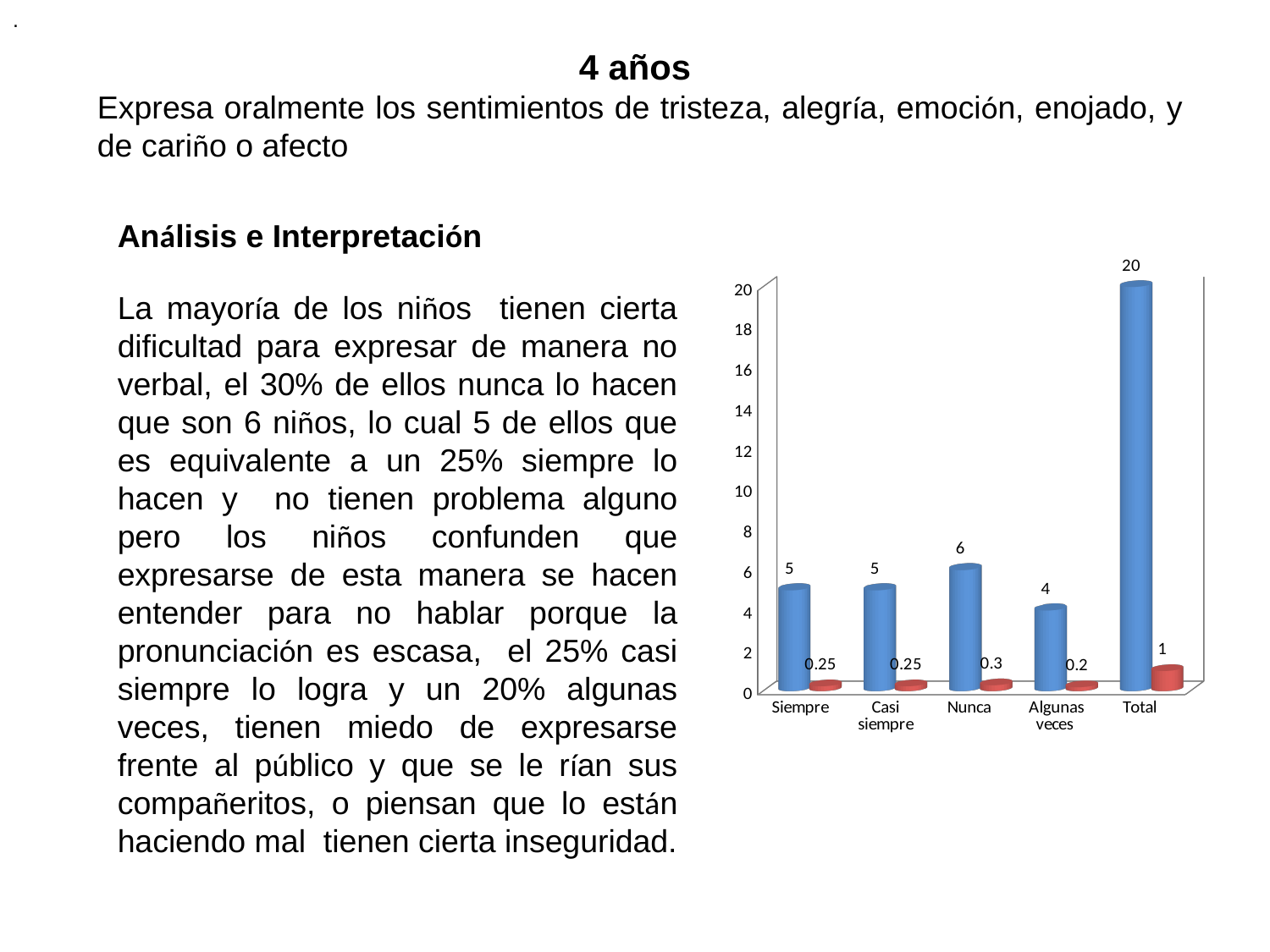
What is the difference between the blue bar values for Total and Nunca? 14 Is the blue bar value for Total greater or less than 10? greater Which category has the highest blue bar? Total Which is larger, the blue bar for Nunca or the blue bar for Algunas veces? Nunca What is the value of the blue bar for Algunas veces? 4 What kind of chart is shown on the slide? bar chart Which category has the lowest blue bar? Algunas veces What is the value of the red bar for Total? 1 How many categories are shown on the x axis of the chart? 5 What is the value of the blue bar for Nunca? 6 What is the value of the red bar for Siempre? 0.25 What is the value of the red bar for Nunca? 0.3